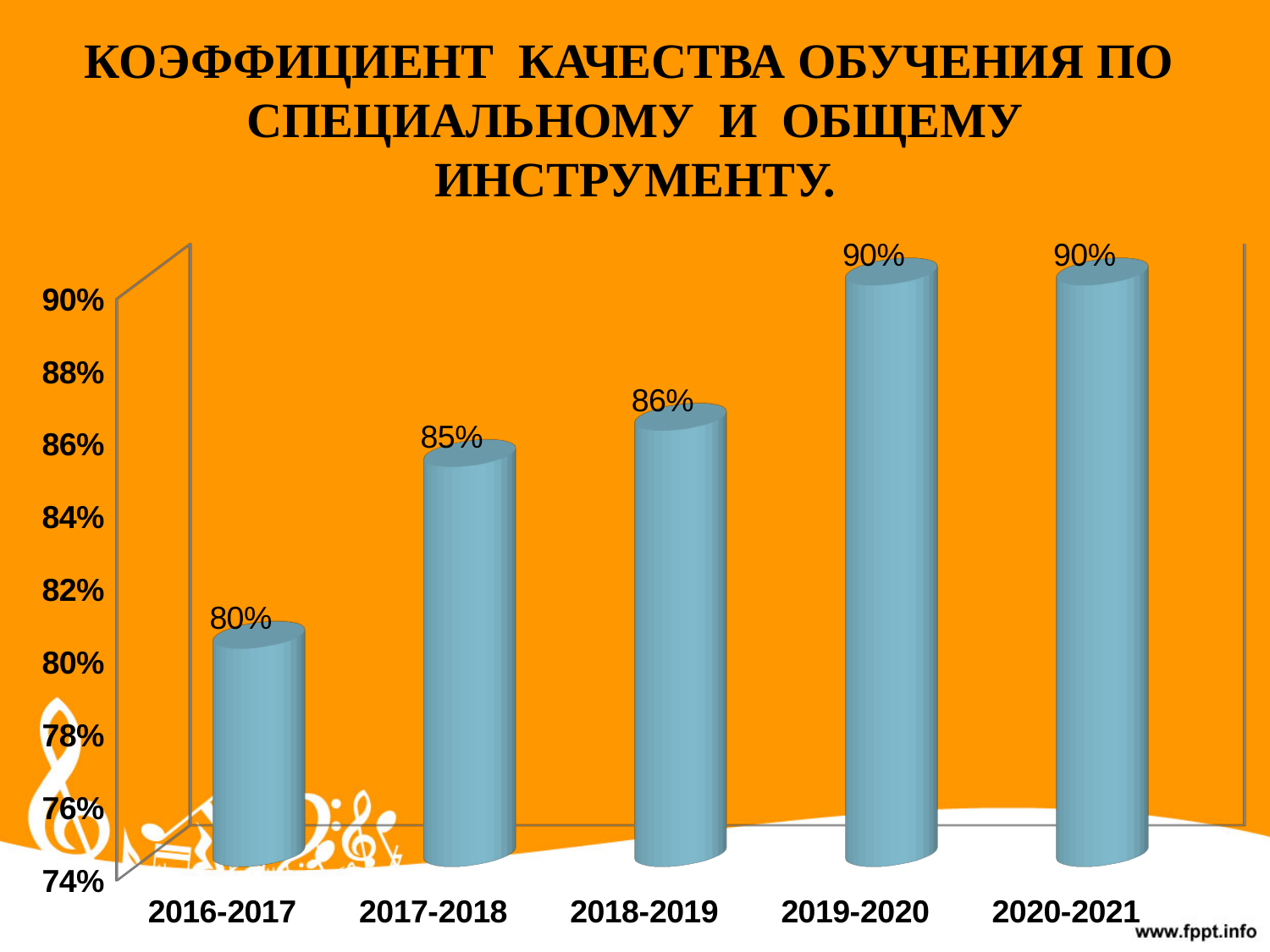
Is the value for 2017-2018 greater or less than 84%? greater Which is larger, the value for 2017-2018 or the value for 2018-2019? 2018-2019 What is the value for 2017-2018? 85% What is the difference between the values for 2018-2019 and 2017-2018? 1% How many categories are shown on the x axis? 5 Do the values rise or fall from 2016-2017 to 2019-2020? rise What is the value for 2018-2019? 86% What is the value for 2016-2017? 80% What is the difference between the values for 2019-2020 and 2016-2017? 10% Which category has the lowest value? 2016-2017 What kind of chart is shown on the slide? bar chart What is the value for 2019-2020? 90%